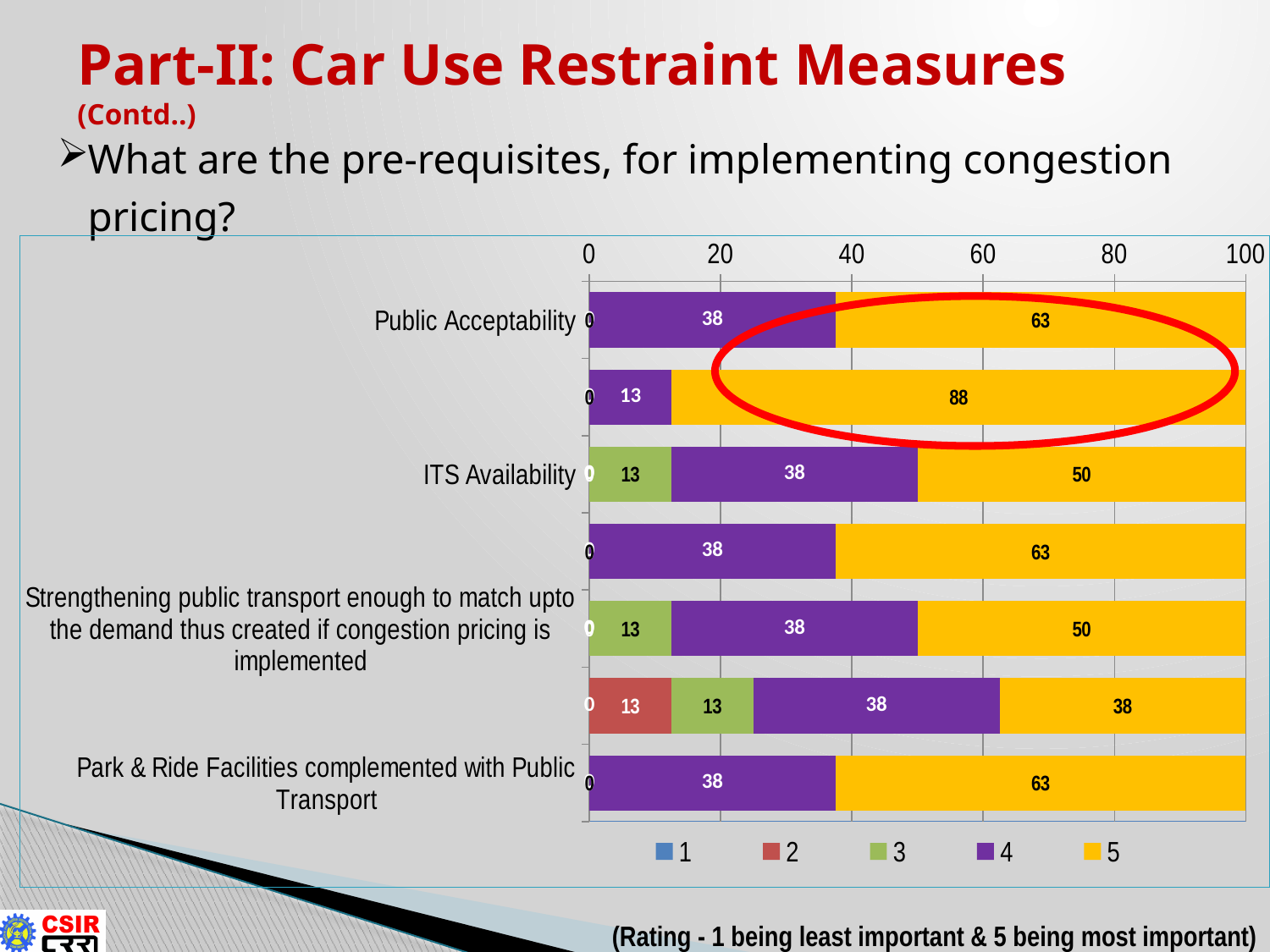
How many series does the chart legend list? 5 What kind of chart is shown on the slide? Stacked bar chart What is the highest value shown on the chart's horizontal axis? 100 What is the value of the rating 5 segment for Public Acceptability? 63 Which has the larger rating 5 segment: Public Acceptability or ITS Availability? Public Acceptability What is the value of the rating 5 segment for Park & Ride Facilities complemented with Public Transport? 63 What is the value of the rating 4 segment for Public Acceptability? 38 What is the difference between the rating 5 segment for Public Acceptability and the rating 5 segment for ITS Availability? 13 What is the value of the rating 4 segment for Strengthening public transport enough to match upto the demand thus created if congestion pricing is implemented? 38 How many bars are plotted in the chart? 7 What is the value of the rating 5 segment for ITS Availability? 50 What is the value of the rating 3 segment for ITS Availability? 13